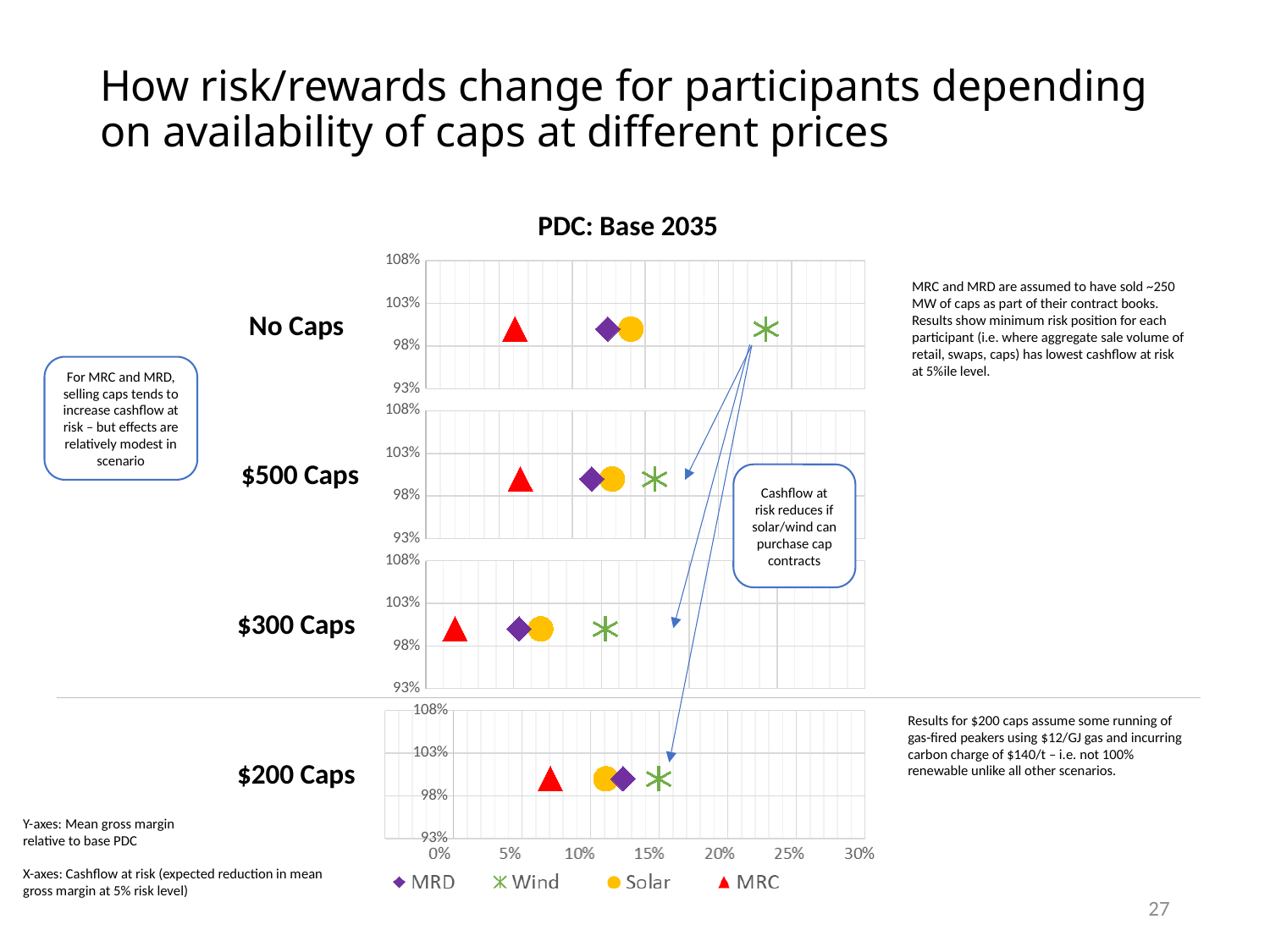
In the '$300 Caps' chart, which has the higher cashflow at risk, Solar or MRC? Solar In the '$200 Caps' chart, which series has the lowest cashflow at risk (x-axis value)? MRC In the '$200 Caps' chart, is the cashflow at risk for MRC greater or less than 10%? less In the 'No Caps' chart, which series has the lowest cashflow at risk (x-axis value)? MRC In the '$500 Caps' chart, is the cashflow at risk for Wind greater or less than 10%? greater What kind of chart is used for the 'No Caps' panel? scatter chart What is the title shown above the set of charts? PDC: Base 2035 How many series does the legend list? 4 In the 'No Caps' chart, which series has the highest cashflow at risk (x-axis value)? Wind In the '$300 Caps' chart, is the cashflow at risk for MRC greater or less than 5%? less How many separate chart panels are shown under the 'PDC: Base 2035' heading? 4